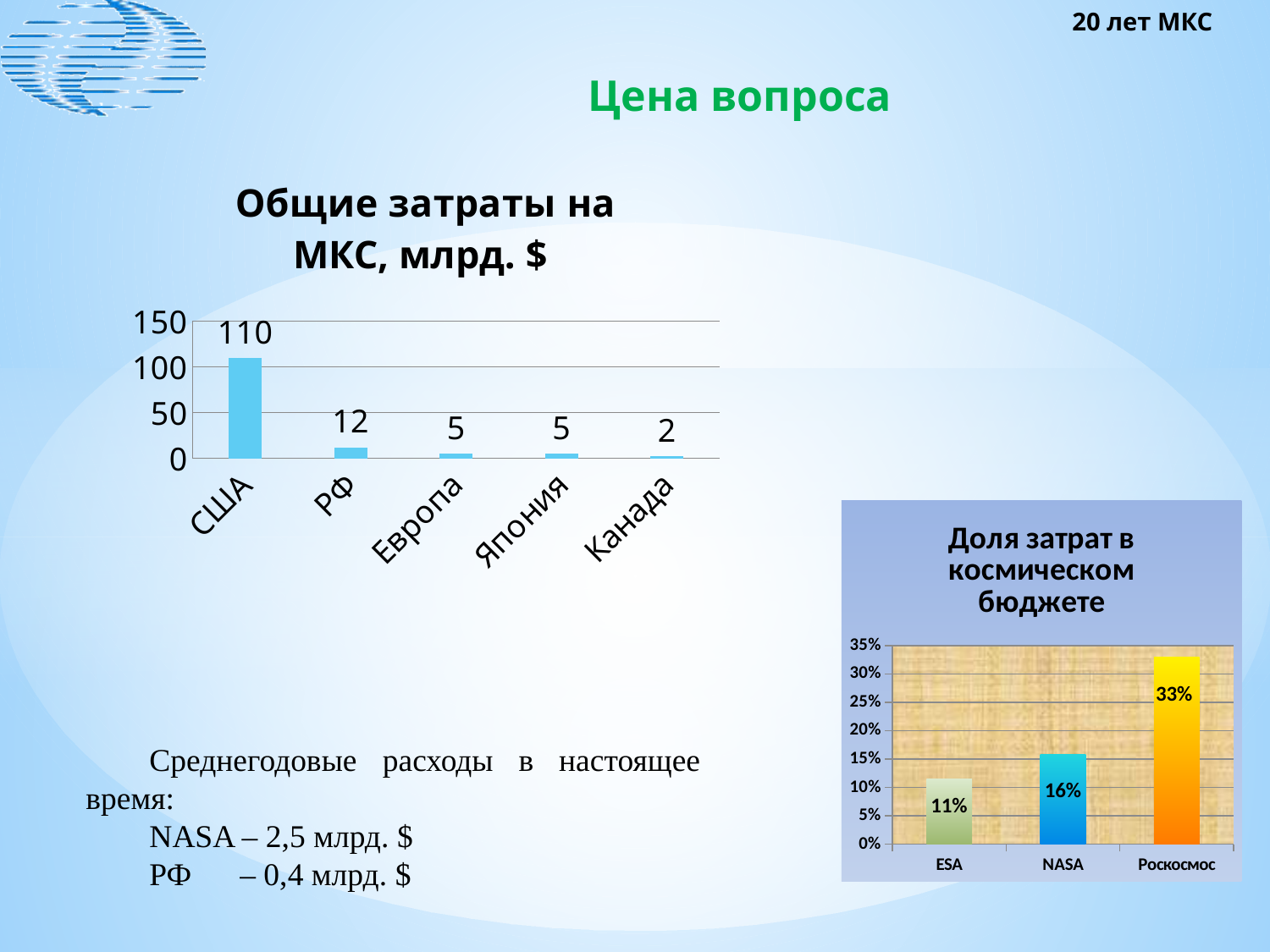
In the chart 'Общие затраты на МКС, млрд. $', which category has the lowest value? Канада In the chart 'Общие затраты на МКС, млрд. $', what is the value for РФ? 12 What type of chart is 'Доля затрат в космическом бюджете'? bar chart In the chart 'Доля затрат в космическом бюджете', what is the value for ESA? 11% In the chart 'Общие затраты на МКС, млрд. $', is the value for США greater or less than 100? greater In the chart 'Доля затрат в космическом бюджете', which is larger, the value for NASA or the value for ESA? NASA In the chart 'Общие затраты на МКС, млрд. $', what is the value for США? 110 In the chart 'Доля затрат в космическом бюджете', what is the difference between the values for Роскосмос and NASA? 17% In the chart 'Доля затрат в космическом бюджете', what is the value for Роскосмос? 33% In the chart 'Общие затраты на МКС, млрд. $', what is the difference between the values for США and РФ? 98 In the chart 'Общие затраты на МКС, млрд. $', which category has the highest value? США In the chart 'Общие затраты на МКС, млрд. $', how many categories are shown? 5